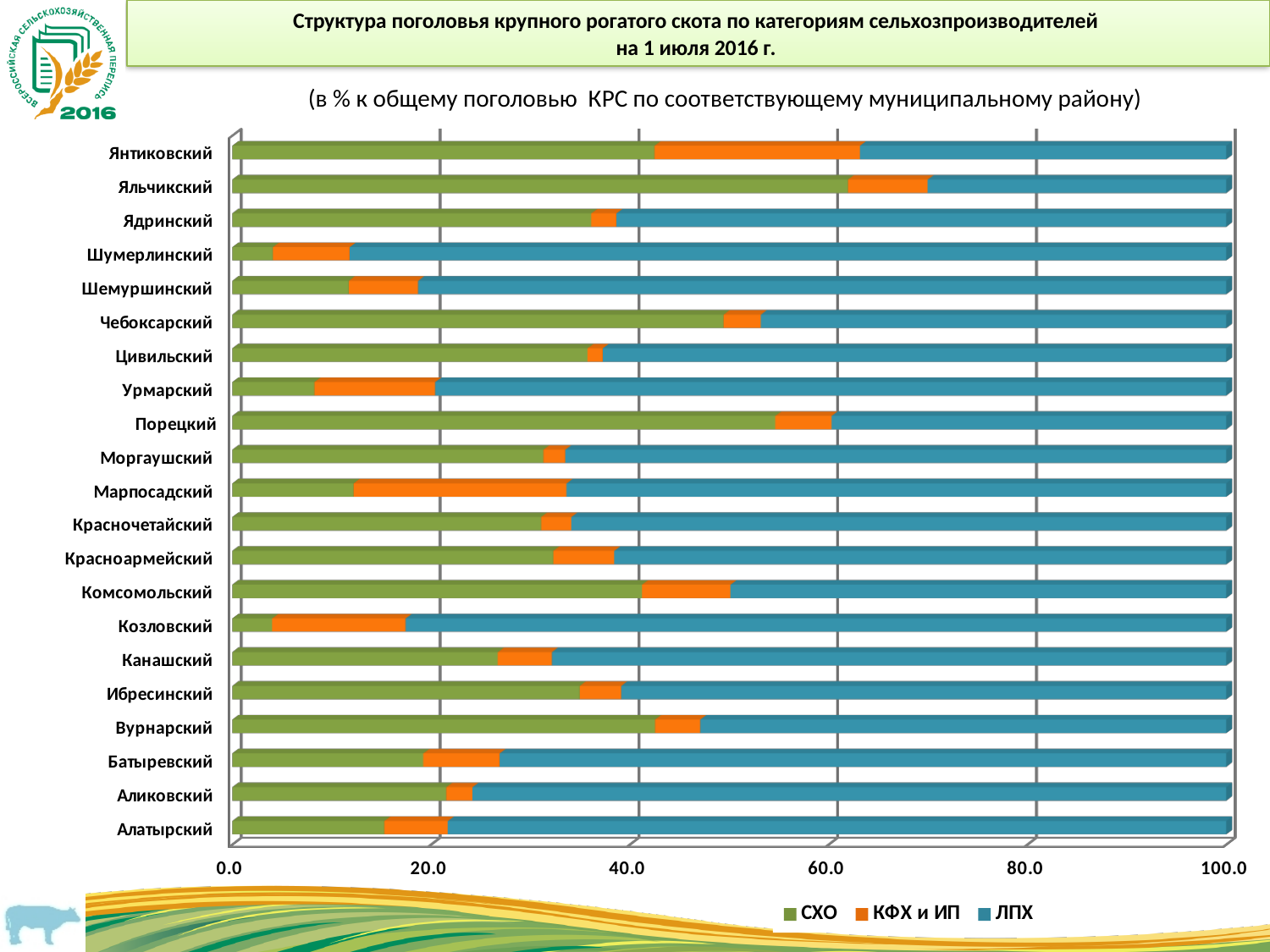
Is the СХО value for Порецкий greater or less than 60.0? less Which district has the larger СХО share, Янтиковский or Ядринский? Янтиковский Is the СХО value for Алатырский greater or less than 20.0? less How many series does the legend list? 3 What is the total of the stacked bar for Козловский? 100.0 How many districts (categories) are plotted on the chart? 21 Which district has the highest share for СХО? Яльчикский What are the three series named in the legend? СХО, КФХ и ИП, ЛПХ Is the СХО value for Яльчикский greater or less than 60.0? greater Which district has the highest share for ЛПХ? Шумерлинский What kind of chart is shown on the slide? stacked bar chart Which district has the lowest share for ЛПХ? Яльчикский